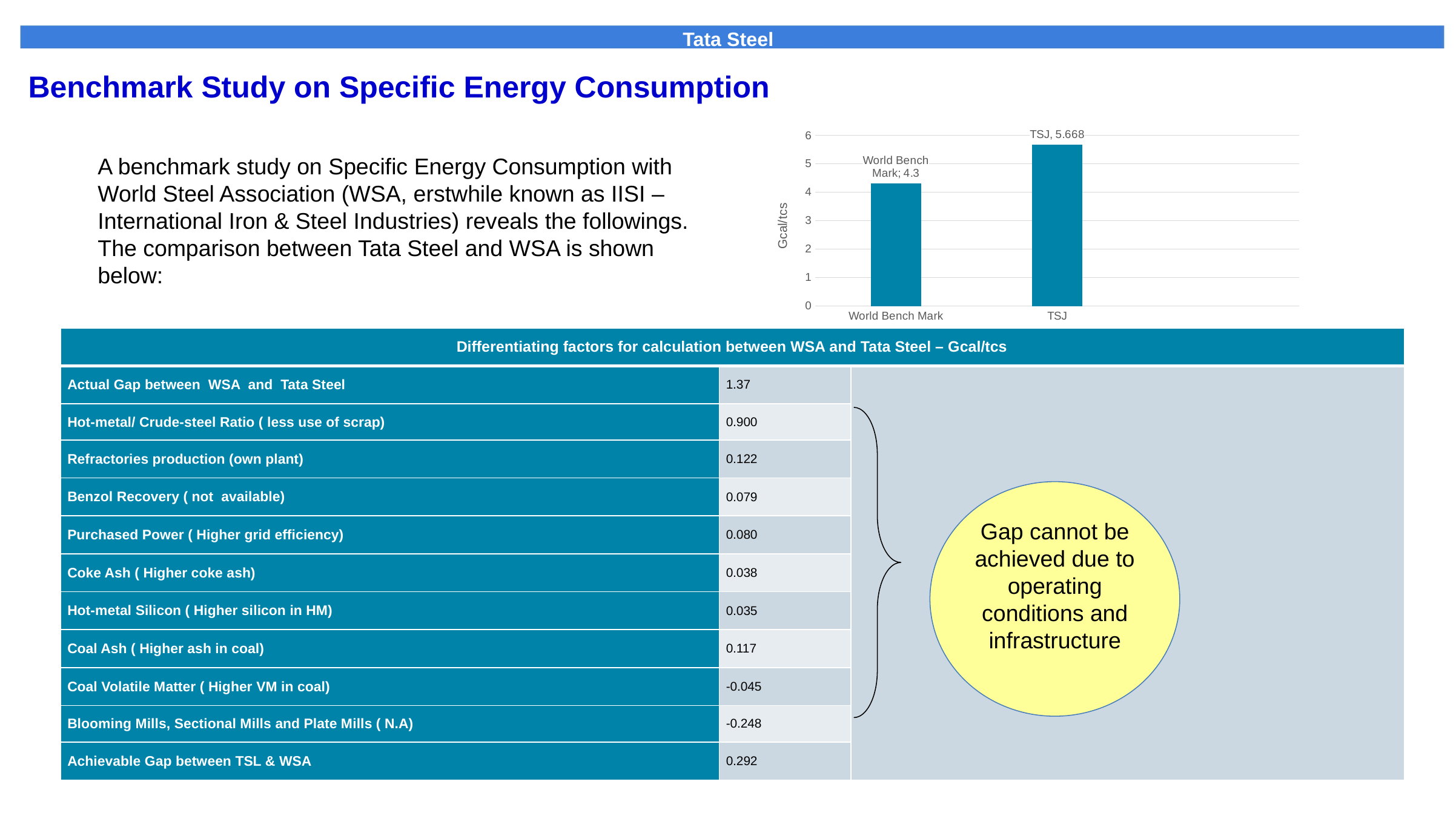
How many categories are shown in the chart? 2 What is the value for TSJ in the chart? 5.668 What is the value for World Bench Mark in the chart? 4.3 Is the value for World Bench Mark in the chart greater or less than 5? less Which category has the highest value in the chart? TSJ Is the value for TSJ in the chart greater or less than 5? greater What kind of chart is shown on the slide? bar chart What is the label of the vertical axis of the chart? Gcal/tcs What is the maximum value shown on the vertical axis of the chart? 6 Which is larger in the chart, World Bench Mark or TSJ? TSJ What is the difference between the TSJ value and the World Bench Mark value in the chart? 1.368 Which category has the lowest value in the chart? World Bench Mark